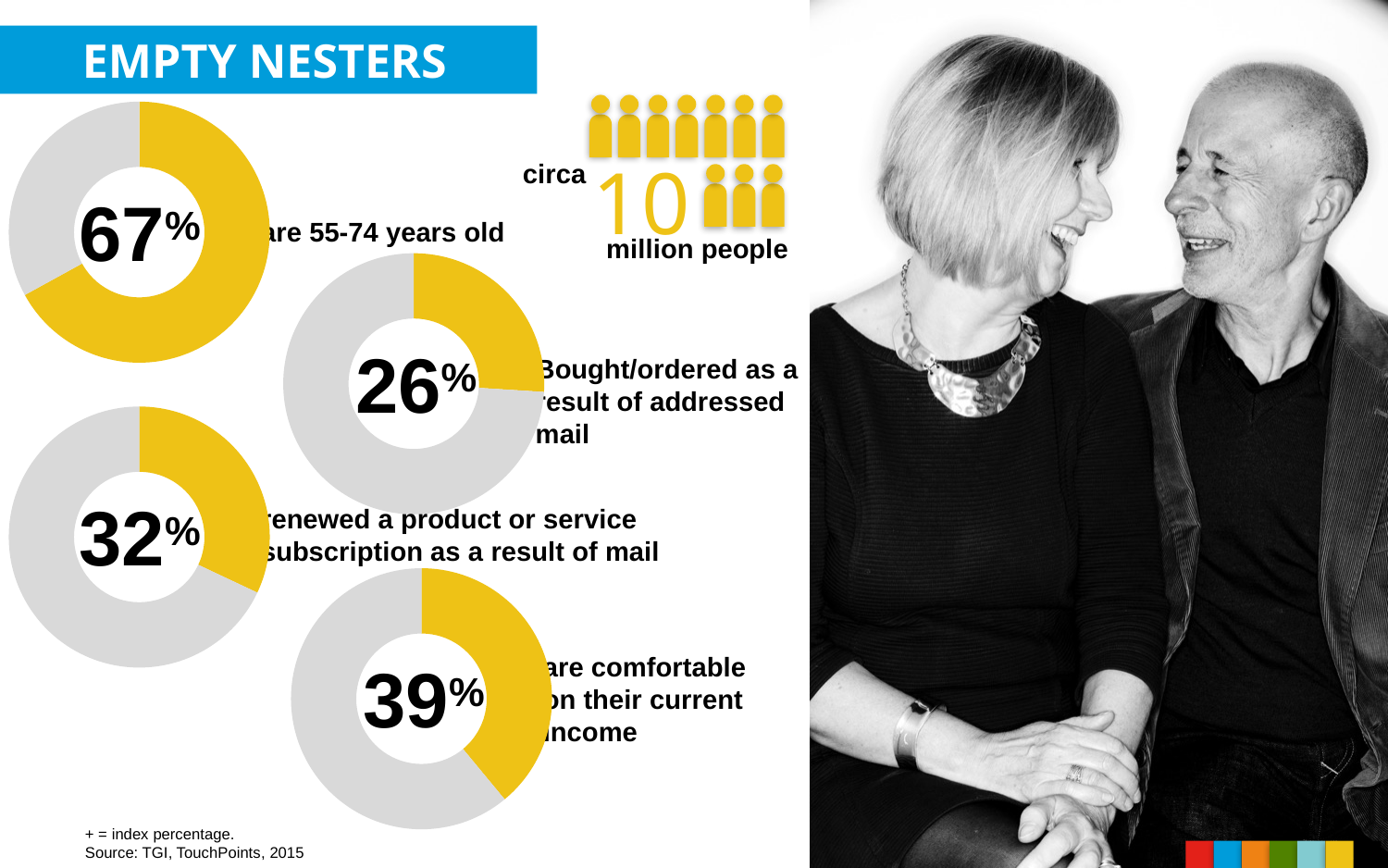
Approximately how many people does the pictogram say are empty nesters? circa 10 million people What percentage of empty nesters are 55-74 years old, according to the top-left donut chart? 67% What percentage of empty nesters are comfortable on their current income? 39% What percentage of empty nesters renewed a product or service subscription as a result of mail? 32% What type of chart is used to show the 67% figure? Donut (pie) chart Which of the four donut charts shows the highest percentage? are 55-74 years old (67%) How many donut charts are shown on the slide? 4 What is the difference between the percentage who renewed a subscription as a result of mail and the percentage who bought/ordered as a result of addressed mail? 6% Which of the four donut charts shows the lowest percentage? Bought/ordered as a result of addressed mail (26%) What percentage of empty nesters bought/ordered as a result of addressed mail? 26% Which is larger: the percentage who renewed a subscription as a result of mail or the percentage who are comfortable on their current income? are comfortable on their current income (39%) What is the difference between the percentage who are 55-74 years old and the percentage who are comfortable on their current income? 28%